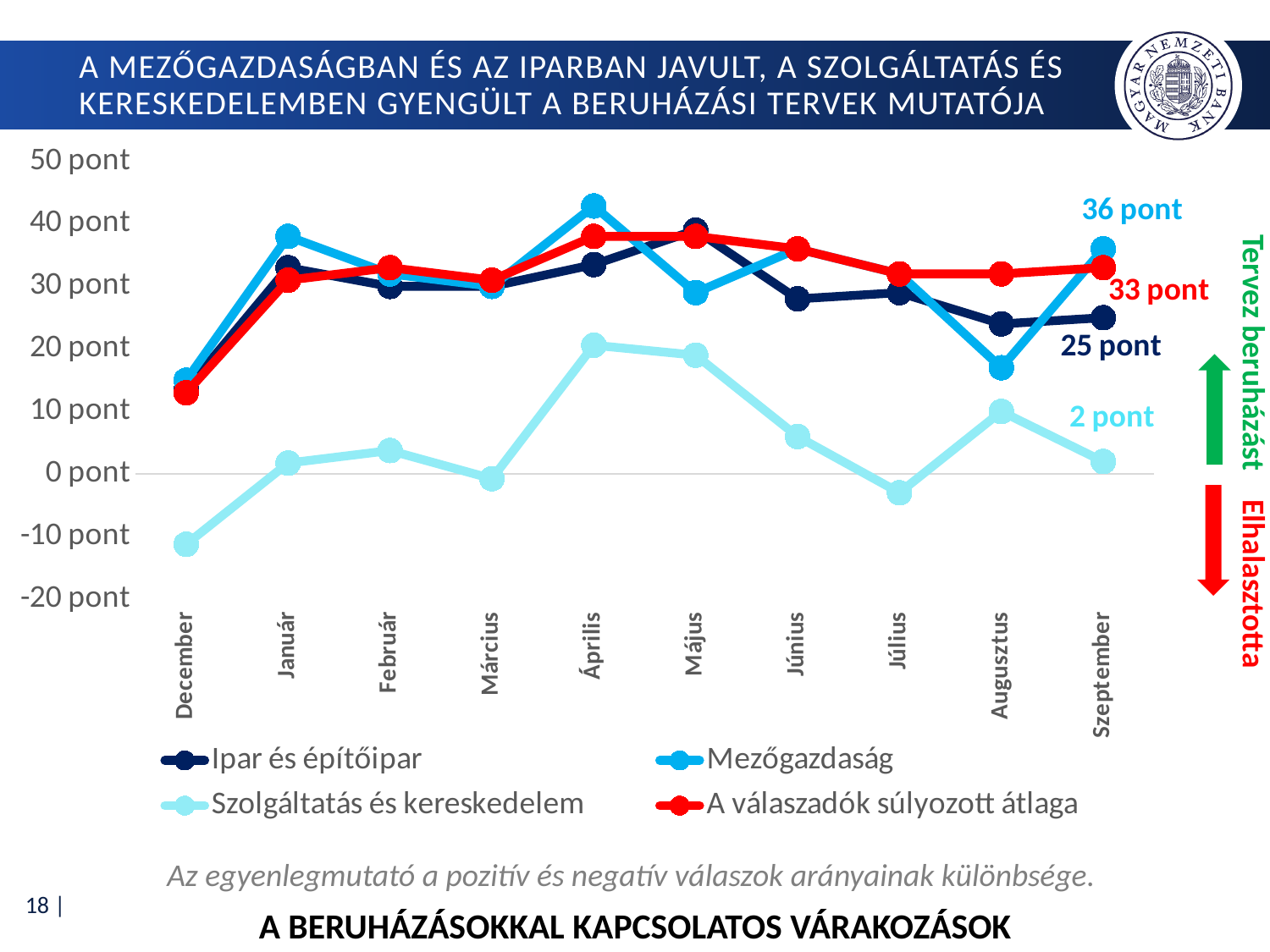
In which month is the Szolgáltatás és kereskedelem series at its lowest? December Is the value for Szolgáltatás és kereskedelem in December greater or less than 0 pont? less How many months are shown on the x axis? 10 Is the value for Mezőgazdaság in Április greater or less than 40 pont? greater What is the value for Mezőgazdaság in Szeptember? 36 pont In which month is the Mezőgazdaság series at its highest? Április What is the value for Ipar és építőipar in Szeptember? 25 pont In Szeptember, which is larger: the value for Mezőgazdaság or the value for Ipar és építőipar? Mezőgazdaság What is the value for Szolgáltatás és kereskedelem in Szeptember? 2 pont How many series does the legend list? 4 In Szeptember, what is the difference between the Mezőgazdaság value and the Ipar és építőipar value? 11 pont What is the value for A válaszadók súlyozott átlaga in Szeptember? 33 pont